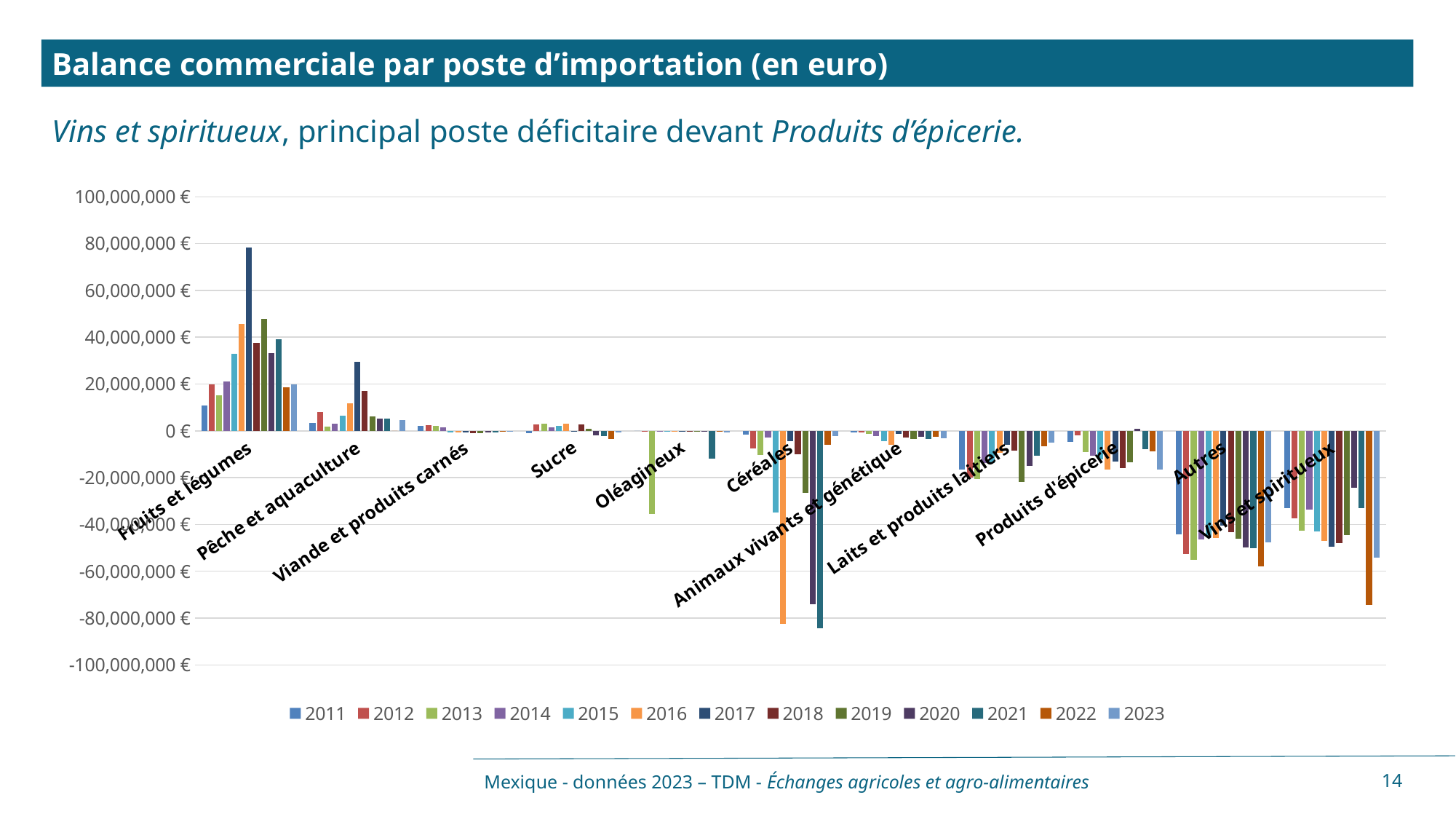
What is the title of the chart? Balance commerciale par poste d'importation (en euro) Is the 2013 value for Oléagineux greater or less than -20,000,000 €? less For Vins et spiritueux, which year has the lowest value? 2022 What kind of chart is shown on the slide? Bar chart For Fruits et légumes, which year has the highest value? 2017 Is the 2022 value for Vins et spiritueux greater or less than -60,000,000 €? less Which years does the legend cover, from first to last? 2011 to 2023 For Fruits et légumes, which is larger: the 2016 value or the 2017 value? 2017 How many series does the legend list? 13 Is the 2017 value for Fruits et légumes greater or less than 60,000,000 €? greater How many import categories are shown on the x axis? 11